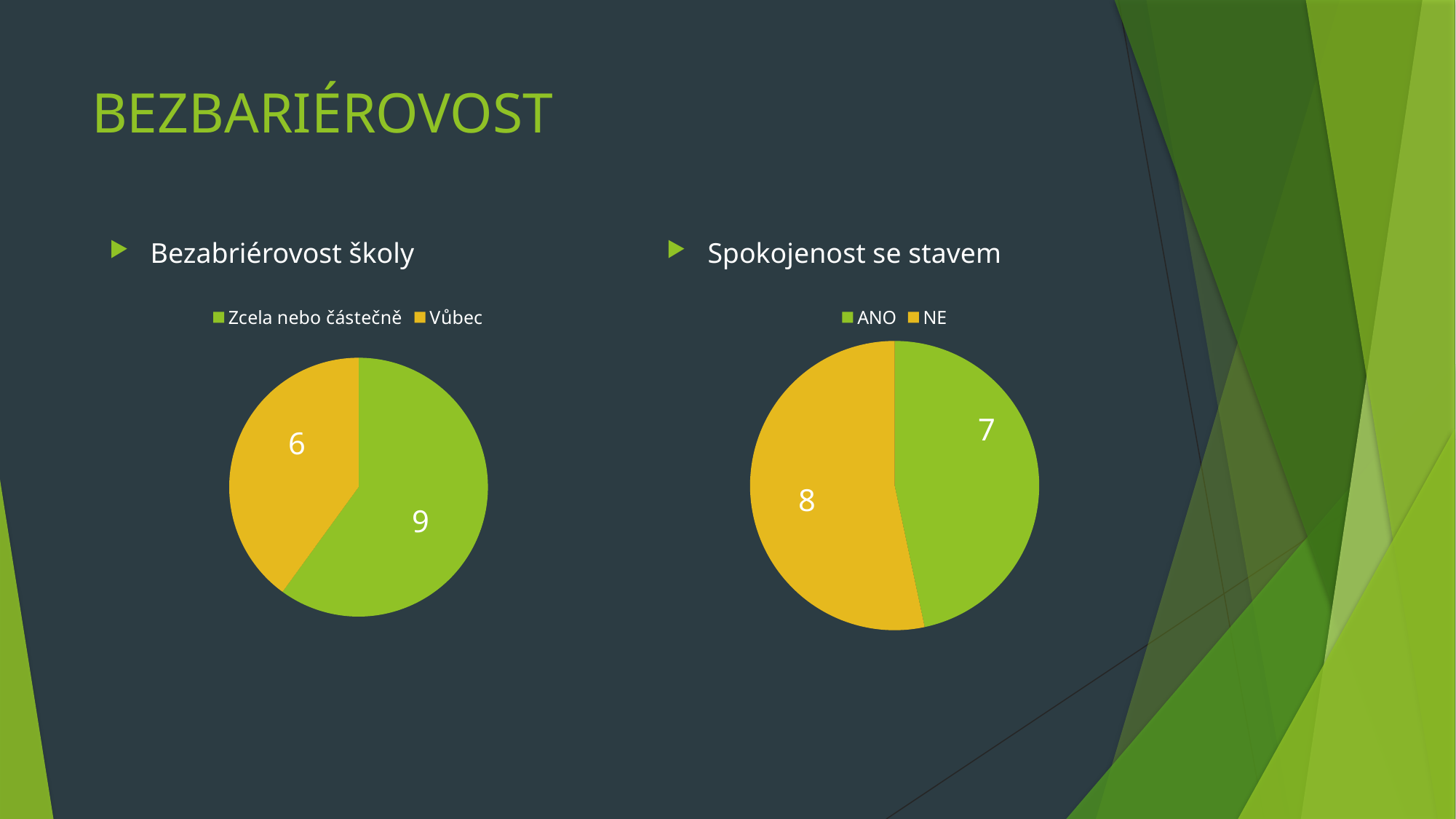
What type of chart is used for "Spokojenost se stavem"? Pie chart In the right pie chart (Spokojenost se stavem), what is the value for "NE"? 8 In the right pie chart (Spokojenost se stavem), which category has the smallest slice? ANO In the right pie chart (Spokojenost se stavem), what is the value for "ANO"? 7 In the right pie chart (Spokojenost se stavem), what is the total of all slices? 15 In the left pie chart (Bezabriérovost školy), what is the value for "Zcela nebo částečně"? 9 In the left pie chart (Bezabriérovost školy), what is the difference between the values for "Zcela nebo částečně" and "Vůbec"? 3 In the left pie chart (Bezabriérovost školy), what is the value for "Vůbec"? 6 How many entries does the legend of the left pie chart (Bezabriérovost školy) list? 2 In the left pie chart (Bezabriérovost školy), which category has the largest slice? Zcela nebo částečně In the right pie chart (Spokojenost se stavem), which is larger, the value for "ANO" or the value for "NE"? NE In the left pie chart (Bezabriérovost školy), what share of the total does "Zcela nebo částečně" represent? 60%